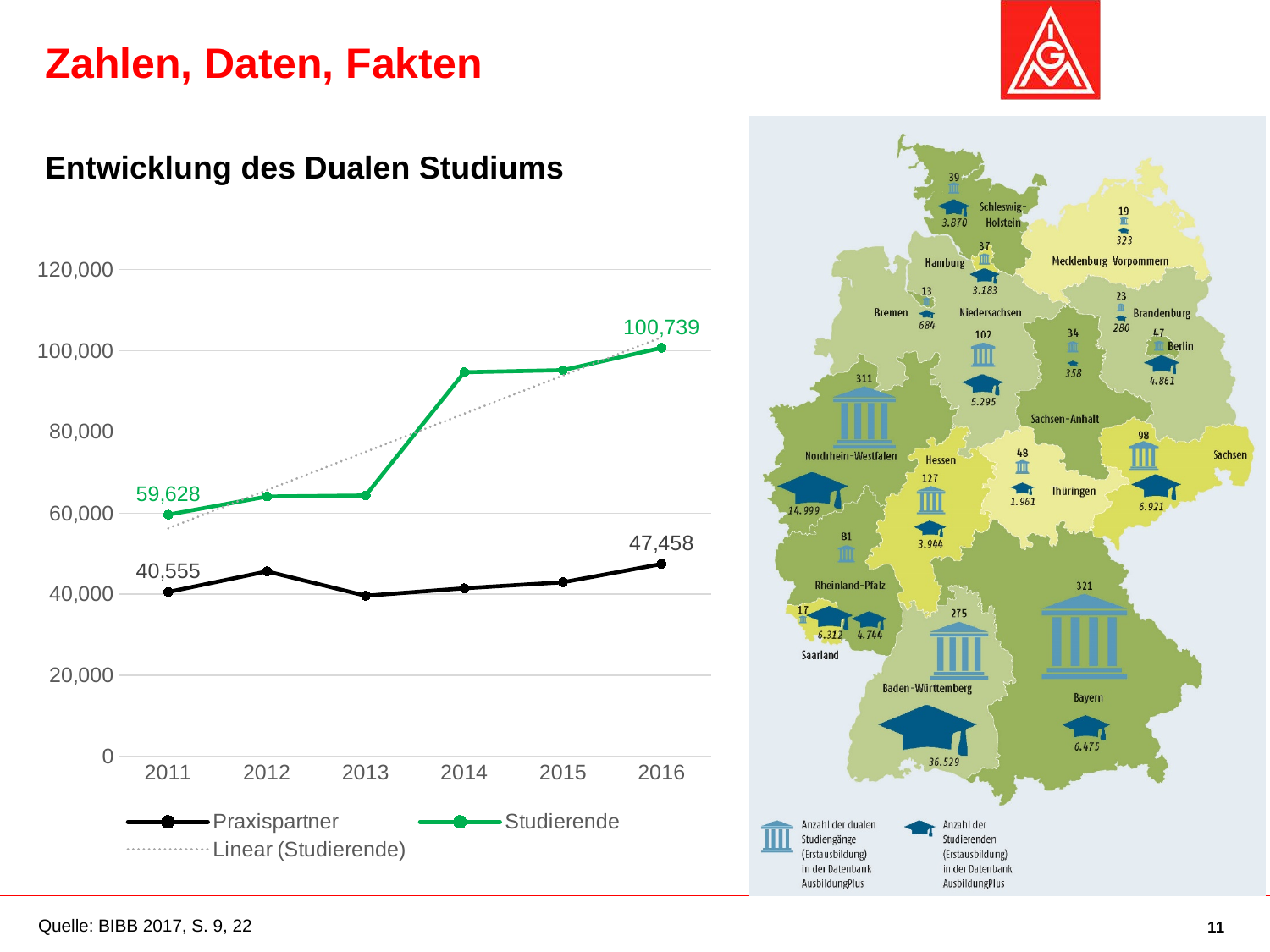
In the chart 'Entwicklung des Dualen Studiums', by how much did Studierende increase from 2011 to 2016? 41,111 How many years are shown on the x axis of the chart 'Entwicklung des Dualen Studiums'? 6 In the chart 'Entwicklung des Dualen Studiums', by how much did Praxispartner increase from 2011 to 2016? 6,903 In the chart 'Entwicklung des Dualen Studiums', is the value for Studierende in 2014 greater or less than 80,000? greater In the chart 'Entwicklung des Dualen Studiums', what is the value for Praxispartner in 2016? 47,458 How many entries does the legend of the chart 'Entwicklung des Dualen Studiums' list? 3 In the chart 'Entwicklung des Dualen Studiums', what is the value for Studierende in 2011? 59,628 What kind of chart is 'Entwicklung des Dualen Studiums'? line chart In the chart 'Entwicklung des Dualen Studiums', is the value for Studierende in 2013 greater or less than 80,000? less In the chart 'Entwicklung des Dualen Studiums', what is the value for Studierende in 2016? 100,739 In the chart 'Entwicklung des Dualen Studiums', which series has the larger value in 2016, Praxispartner or Studierende? Studierende In the chart 'Entwicklung des Dualen Studiums', what is the value for Praxispartner in 2011? 40,555